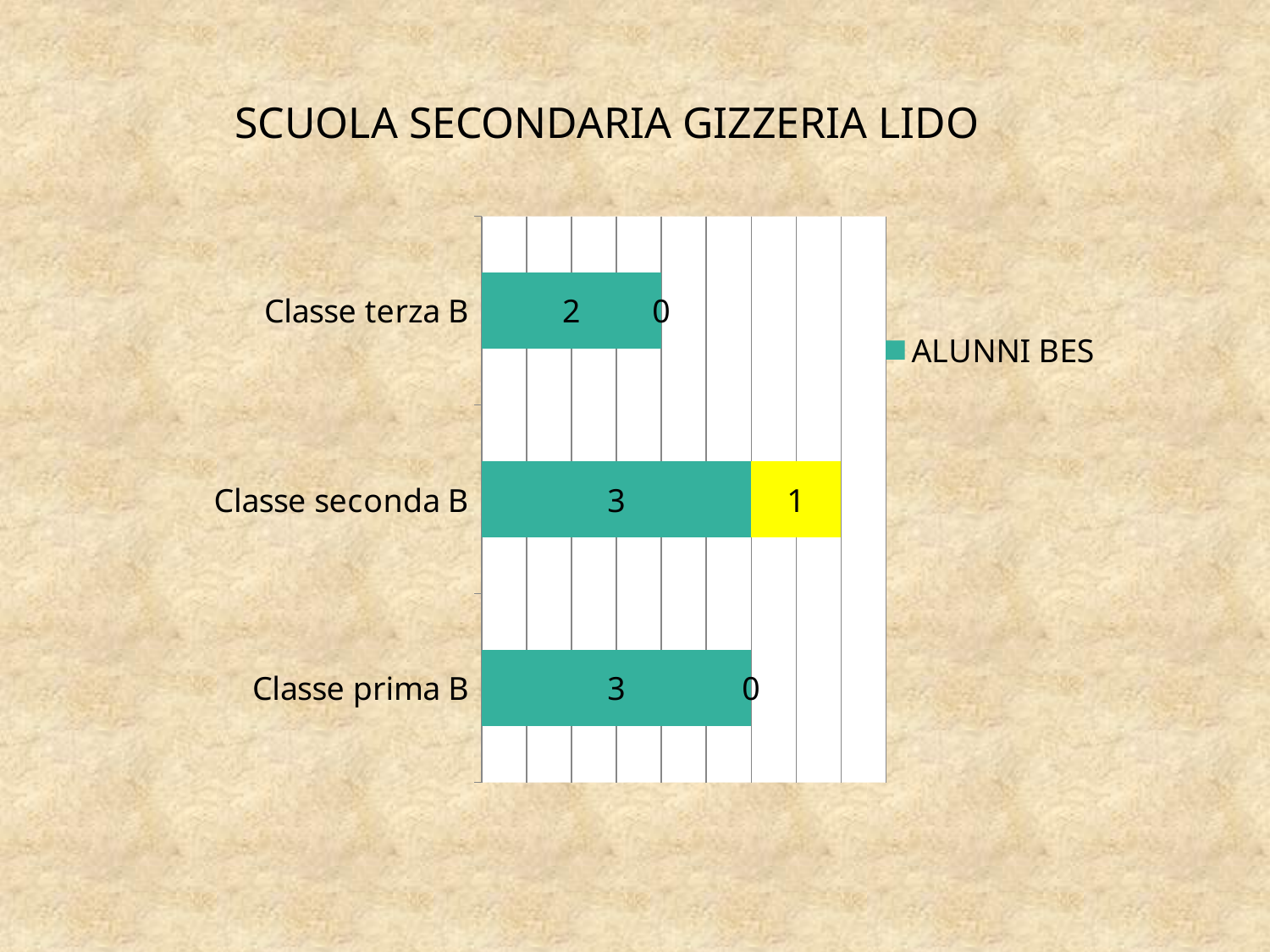
What is the difference between the ALUNNI BES values for Classe seconda B and Classe terza B? 1 What is the title of the slide? SCUOLA SECONDARIA GIZZERIA LIDO Which has a larger ALUNNI BES value, Classe terza B or Classe seconda B? Classe seconda B What is the total of the stacked bar for Classe seconda B? 4 Which class has the lowest ALUNNI BES value? Classe terza B How many classes are shown on the chart? 3 What is the ALUNNI BES value for Classe terza B? 2 What kind of chart is shown on the slide? Bar chart How many series does the legend list? 1 What is the ALUNNI BES value for Classe prima B? 3 What is the ALUNNI BES value for Classe seconda B? 3 What value is shown on the yellow segment of the Classe seconda B bar? 1